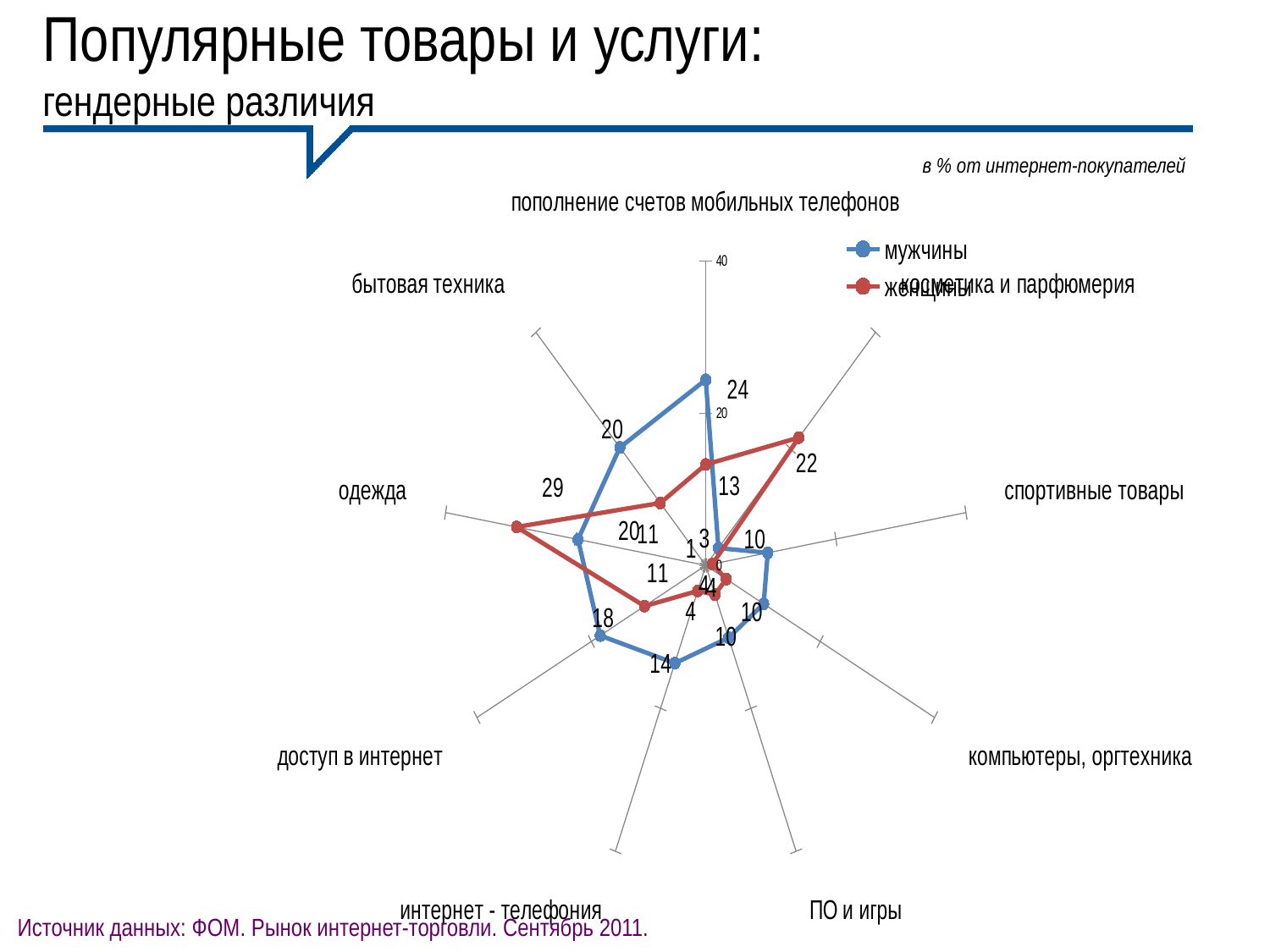
What kind of chart is shown on the slide? radar chart What is the value for мужчины for пополнение счетов мобильных телефонов? 24 Which category has the highest value for женщины? одежда What is the difference between the мужчины and женщины values for пополнение счетов мобильных телефонов? 11 How many categories (axes) does the radar chart have? 9 What is the value for мужчины for интернет - телефония? 14 For одежда, which series has the larger value, мужчины or женщины? женщины Which category has the highest value for мужчины? пополнение счетов мобильных телефонов How many series does the legend list? 2 What is the value for женщины for косметика и парфюмерия? 22 What is the value for мужчины for доступ в интернет? 18 What is the value for женщины for одежда? 29